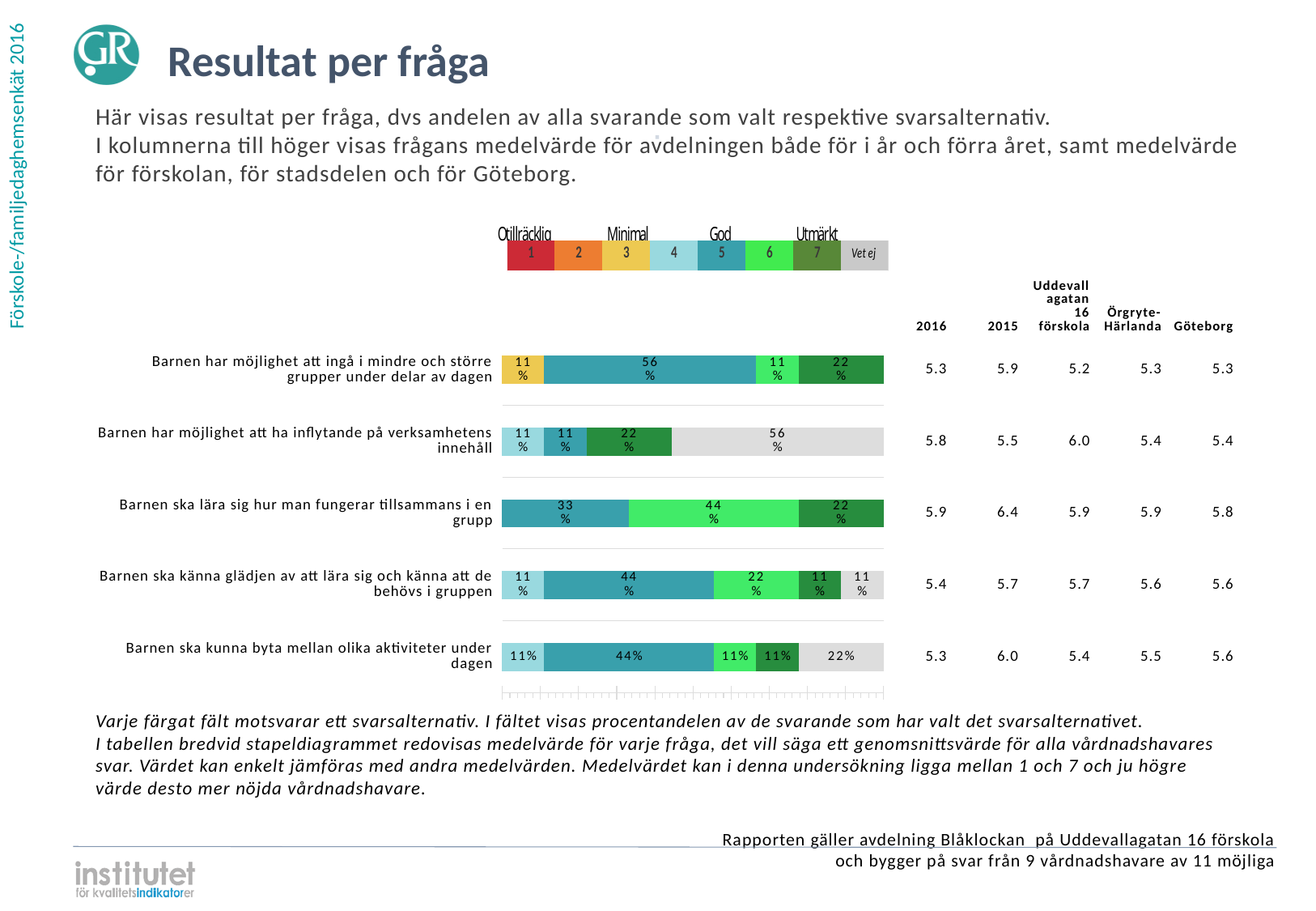
What is the 2015 mean value for 'Barnen ska kunna byta mellan olika aktiviteter under dagen'? 6.0 How many questions (bars) are shown in the chart? 5 What kind of chart is used to show the answer distribution per question? Stacked bar chart For 'Barnen ska lära sig hur man fungerar tillsammans i en grupp', which is larger: the share for alternative 5 or alternative 6? Alternative 6 How many answer alternatives does the legend above the chart list? 8 What is the 2016 mean value for 'Barnen ska lära sig hur man fungerar tillsammans i en grupp'? 5.9 What percentage chose 'Vet ej' for 'Barnen ska kunna byta mellan olika aktiviteter under dagen'? 22% What percentage chose alternative 6 (light green) for 'Barnen ska lära sig hur man fungerar tillsammans i en grupp'? 44% What percentage of respondents chose alternative 5 (teal) for 'Barnen har möjlighet att ingå i mindre och större grupper under delar av dagen'? 56% Which answer alternative has the largest share for 'Barnen ska känna glädjen av att lära sig och känna att de behövs i gruppen'? 5 (44%) What is the difference between the share for alternative 5 and the share for alternative 7 in 'Barnen har möjlighet att ingå i mindre och större grupper under delar av dagen'? 34 percentage points What percentage chose 'Vet ej' for 'Barnen har möjlighet att ha inflytande på verksamhetens innehåll'? 56%